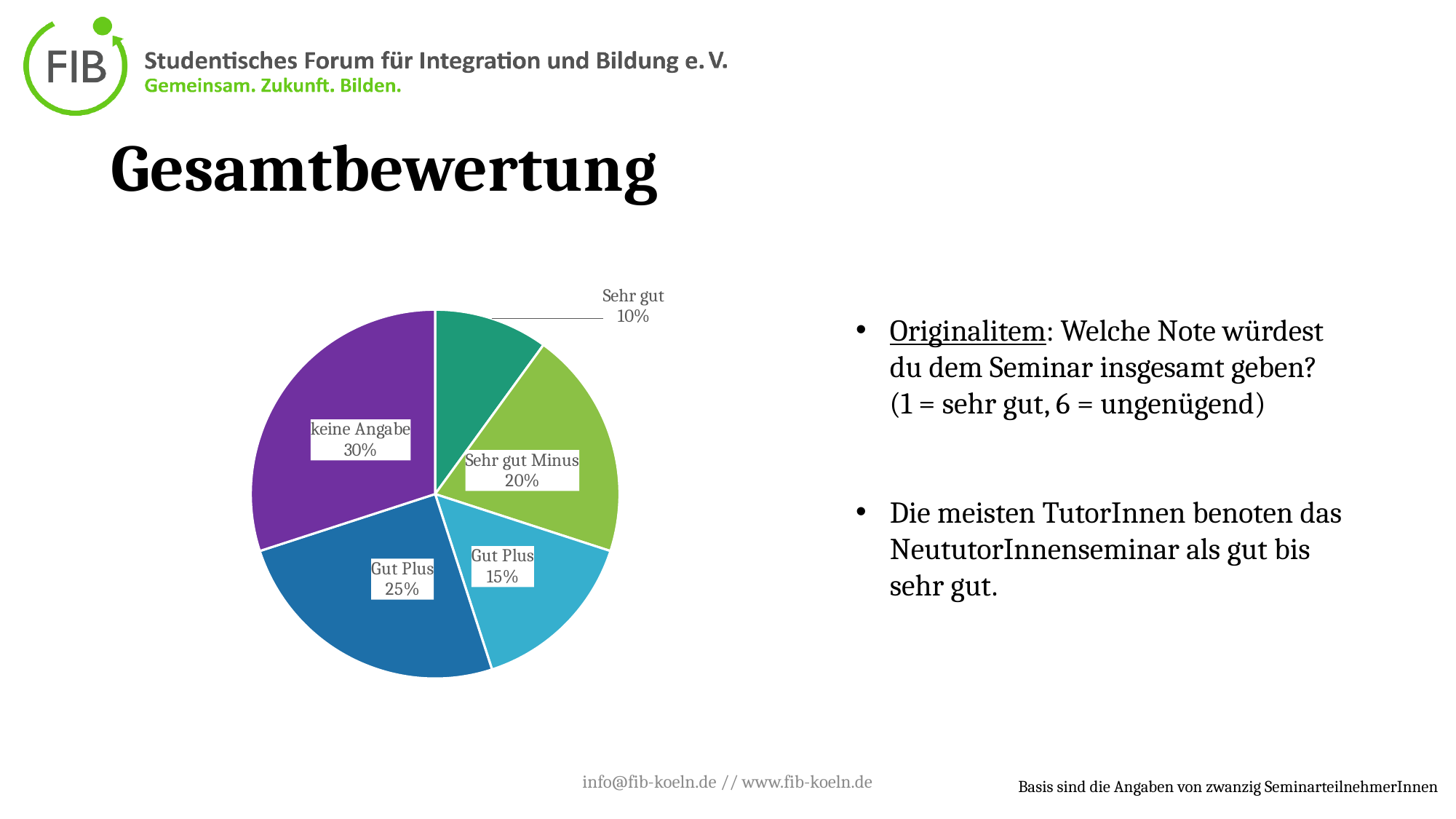
What share does the dark blue "Gut Plus" slice represent? 25% Which slice of the pie chart is the largest? keine Angabe What share does the light blue "Gut Plus" slice represent? 15% What share of the pie does the "keine Angabe" slice represent? 30% Which slice of the pie chart is the smallest? Sehr gut Which is larger, the "Sehr gut Minus" slice or the "Sehr gut" slice? Sehr gut Minus How many slices does the pie chart have? 5 What is the title of the slide containing the pie chart? Gesamtbewertung What kind of chart is shown on the slide? pie chart What is the difference in percentage points between the "keine Angabe" slice and the "Sehr gut" slice? 20